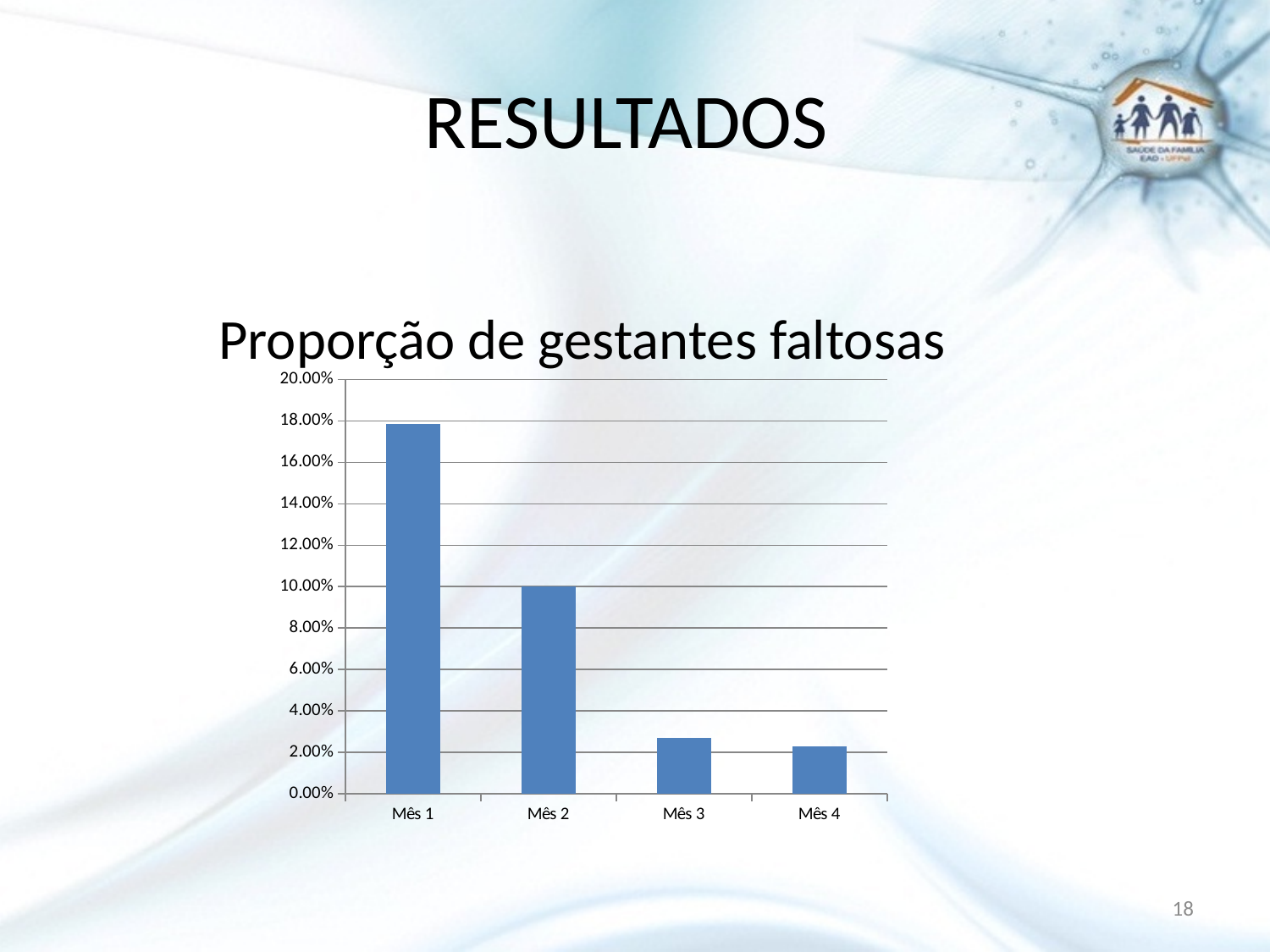
What is the title of the chart? Proporção de gestantes faltosas Which is larger, the value for Mês 1 or the value for Mês 2? Mês 1 Do the values rise or fall from Mês 1 to Mês 4? fall What is the maximum value shown on the vertical axis? 20.00% How many categories (months) are shown on the x axis? 4 Is the value for Mês 3 greater or less than 4.00%? less What kind of chart is shown on the slide? bar chart Which month has the highest proportion of absent pregnant women? Mês 1 Which month has the lowest proportion of absent pregnant women? Mês 4 Is the value for Mês 4 greater or less than 2.00%? greater Is the value for Mês 1 greater or less than 16.00%? greater